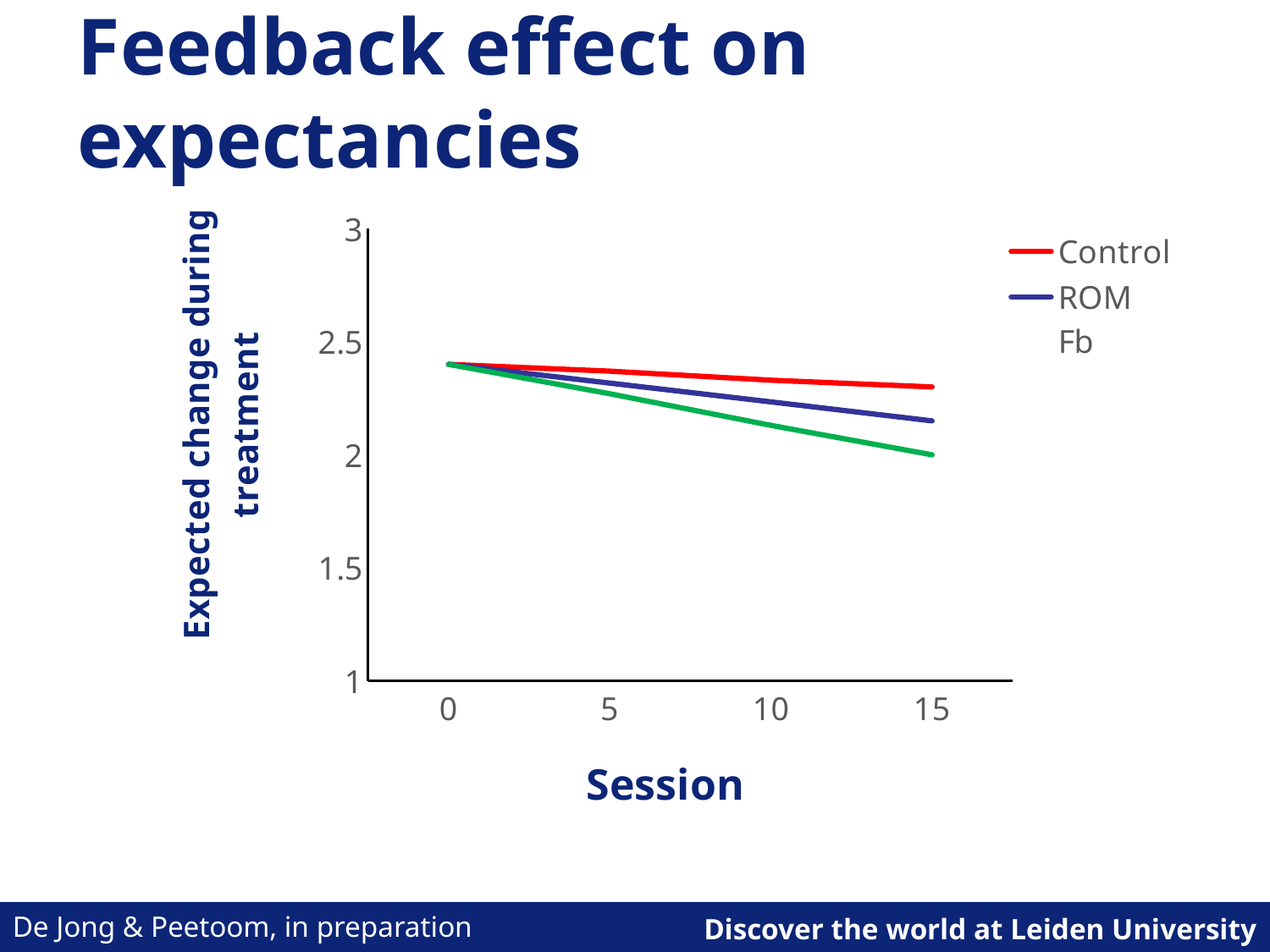
Does the Control line rise or fall as Session increases? fall How many series does the legend list? 2 At session 15, which is higher: Control or ROM Fb? Control Is the value for Control at session 15 greater or less than 2? greater Does the ROM Fb line rise or fall as Session increases? fall What kind of chart is shown on the slide? line chart Is the value for ROM Fb at session 15 greater or less than 2? greater How many lines are plotted on the chart? 3 What is the title of the x axis? Session What colour is the Control line? red Which of the legend series has the lowest value at session 15? ROM Fb Is the value for Control at session 15 greater or less than 2.5? less